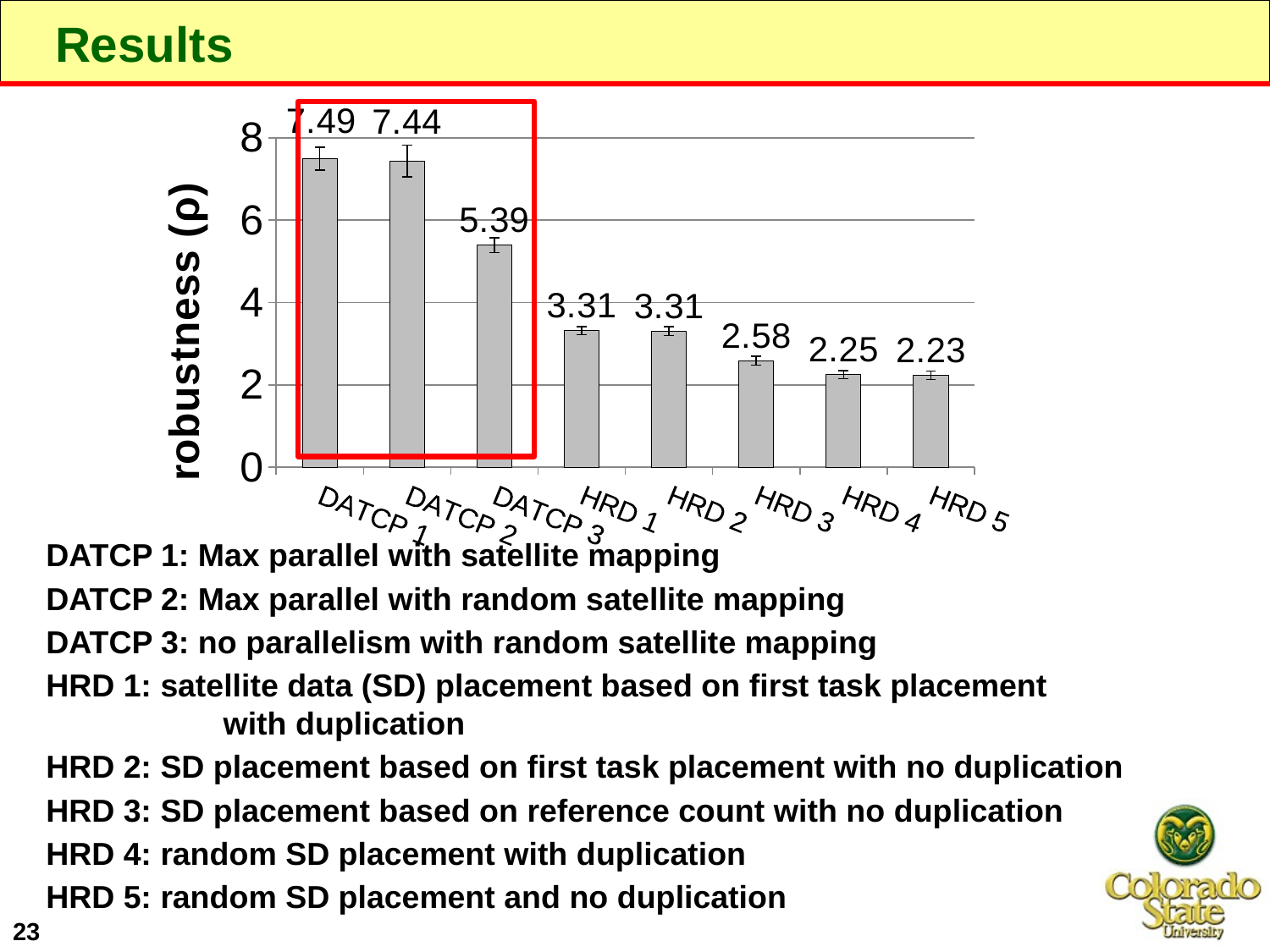
Which category has the lowest robustness value? HRD 5 What is the robustness value for HRD 3? 2.58 What is the difference between the robustness values of DATCP 1 and DATCP 3? 2.1 What kind of chart is shown on the slide? bar chart What is the robustness value for DATCP 1? 7.49 What is the difference between the robustness values of HRD 1 and HRD 3? 0.73 Which category has the highest robustness value? DATCP 1 How many categories are shown on the x axis of the chart? 8 Is the robustness value for HRD 4 greater or less than 4? less What is the label of the y axis of the chart? robustness (ρ) Which has a larger robustness value, DATCP 3 or HRD 1? DATCP 3 What is the robustness value for DATCP 3? 5.39